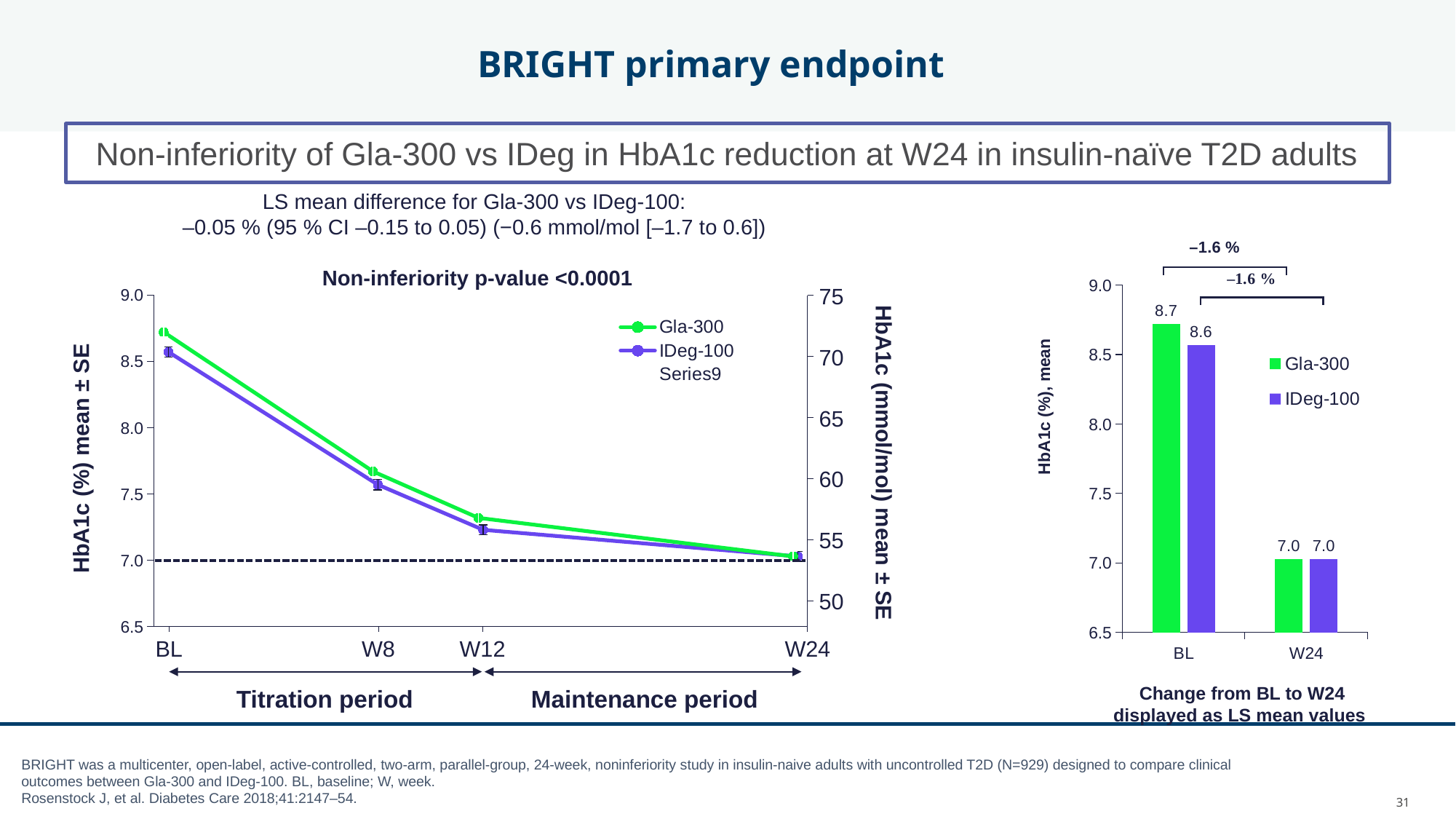
In the bar chart on the right, how many series does the legend list? 2 How many entries does the legend of the line chart on the left list? 3 In the line chart on the left, is the Gla-300 value at BL greater or less than 8.5? greater How many time points are shown on the x axis of the line chart on the left? 4 In the line chart on the left, is the IDeg-100 value at W12 greater or less than 7.5? less What kind of chart is the chart on the right of the slide? bar chart In the bar chart on the right, what is the HbA1c value for IDeg-100 at W24? 7.0 In the bar chart on the right, what is the difference between the IDeg-100 values at BL and W24? 1.6 What kind of chart is the chart on the left of the slide? line chart In the line chart on the left, do the HbA1c values rise or fall from BL to W24? fall In the line chart on the left, which series has the higher value at BL, Gla-300 or IDeg-100? Gla-300 In the bar chart on the right, what is the HbA1c value for Gla-300 at BL? 8.7